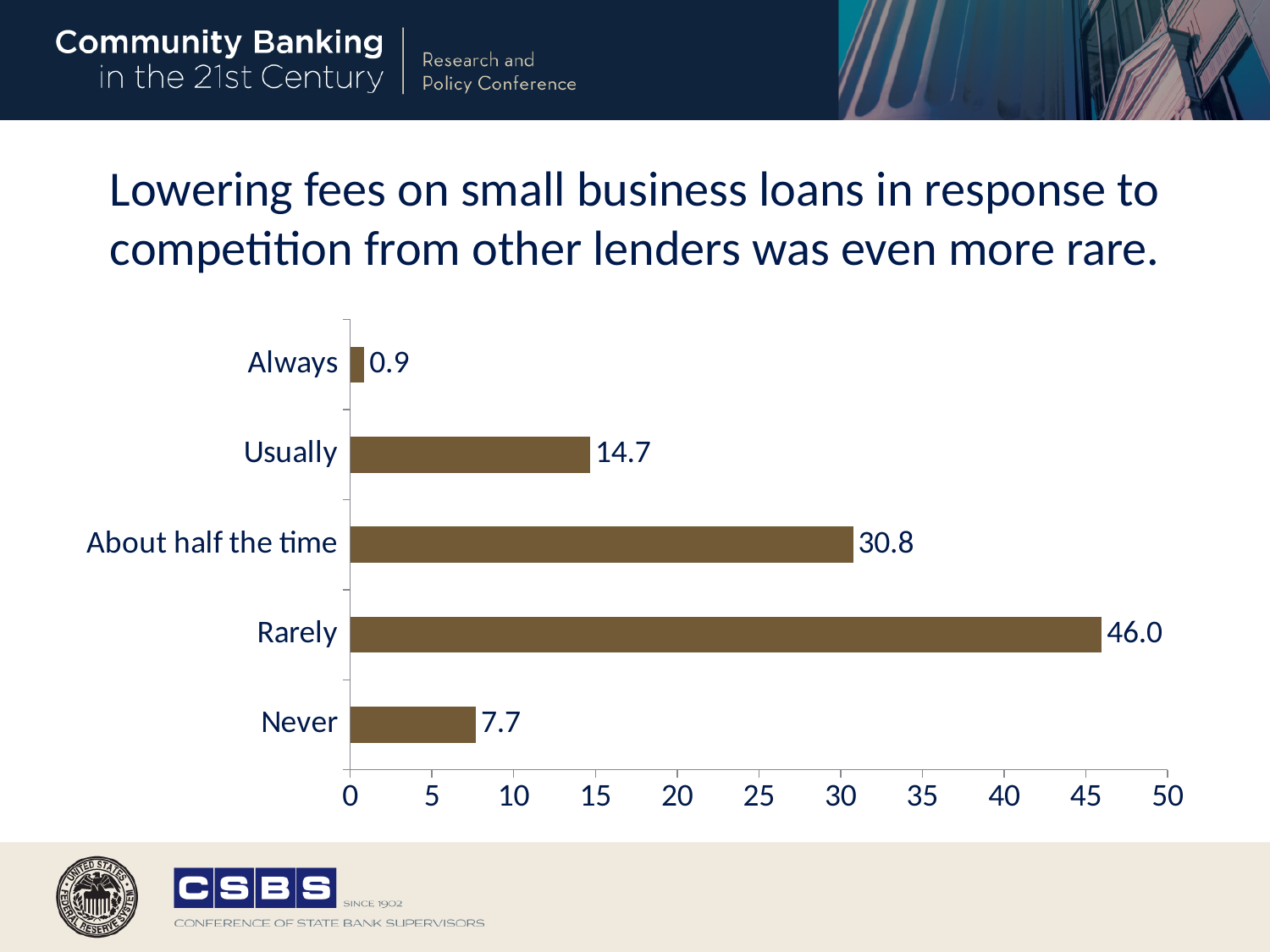
What is the highest value shown on the horizontal axis? 50 What is the value for Rarely? 46.0 What is the difference between the values for Rarely and About half the time? 15.2 Which is larger, the value for Never or the value for Usually? Usually What is the value for About half the time? 30.8 Which category has the lowest value? Always Which category has the highest value? Rarely What is the value for Never? 7.7 What is the value for Usually? 14.7 What kind of chart is shown on the slide? Bar chart How many categories are shown in the chart? 5 What is the difference between the values for Usually and Never? 7.0